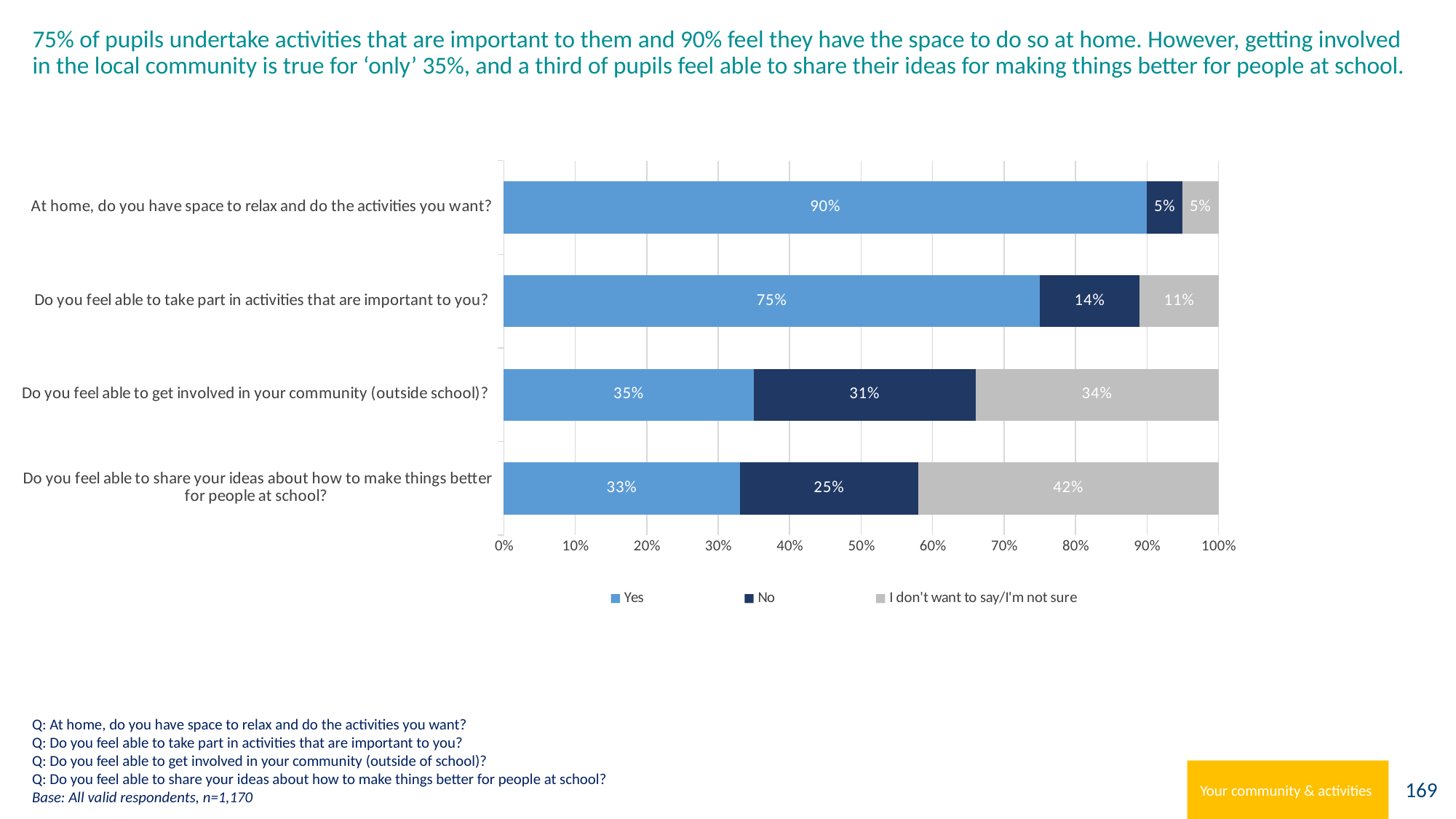
What percentage of pupils answered 'Yes' to 'Do you feel able to get involved in your community (outside school)?' 35% What kind of chart is shown on the slide? Stacked bar chart What percentage of pupils answered 'Yes' to 'At home, do you have space to relax and do the activities you want?' 90% What percentage of pupils answered 'I don't want to say/I'm not sure' to 'Do you feel able to share your ideas about how to make things better for people at school?' 42% What percentage of pupils answered 'No' to 'Do you feel able to take part in activities that are important to you?' 14% How many series does the legend list? 3 What is the base (number of respondents) stated for the chart? n=1,170 Which question has the lowest 'Yes' percentage? Do you feel able to share your ideas about how to make things better for people at school? How many questions (bars) are shown in the chart? 4 Which question has the highest 'Yes' percentage? At home, do you have space to relax and do the activities you want? Which is larger: the 'No' percentage for 'Do you feel able to get involved in your community (outside school)?' or the 'No' percentage for 'Do you feel able to share your ideas about how to make things better for people at school?' Do you feel able to get involved in your community (outside school)? What is the difference between the 'Yes' percentage for 'At home, do you have space to relax and do the activities you want?' and the 'Yes' percentage for 'Do you feel able to take part in activities that are important to you?' 15%